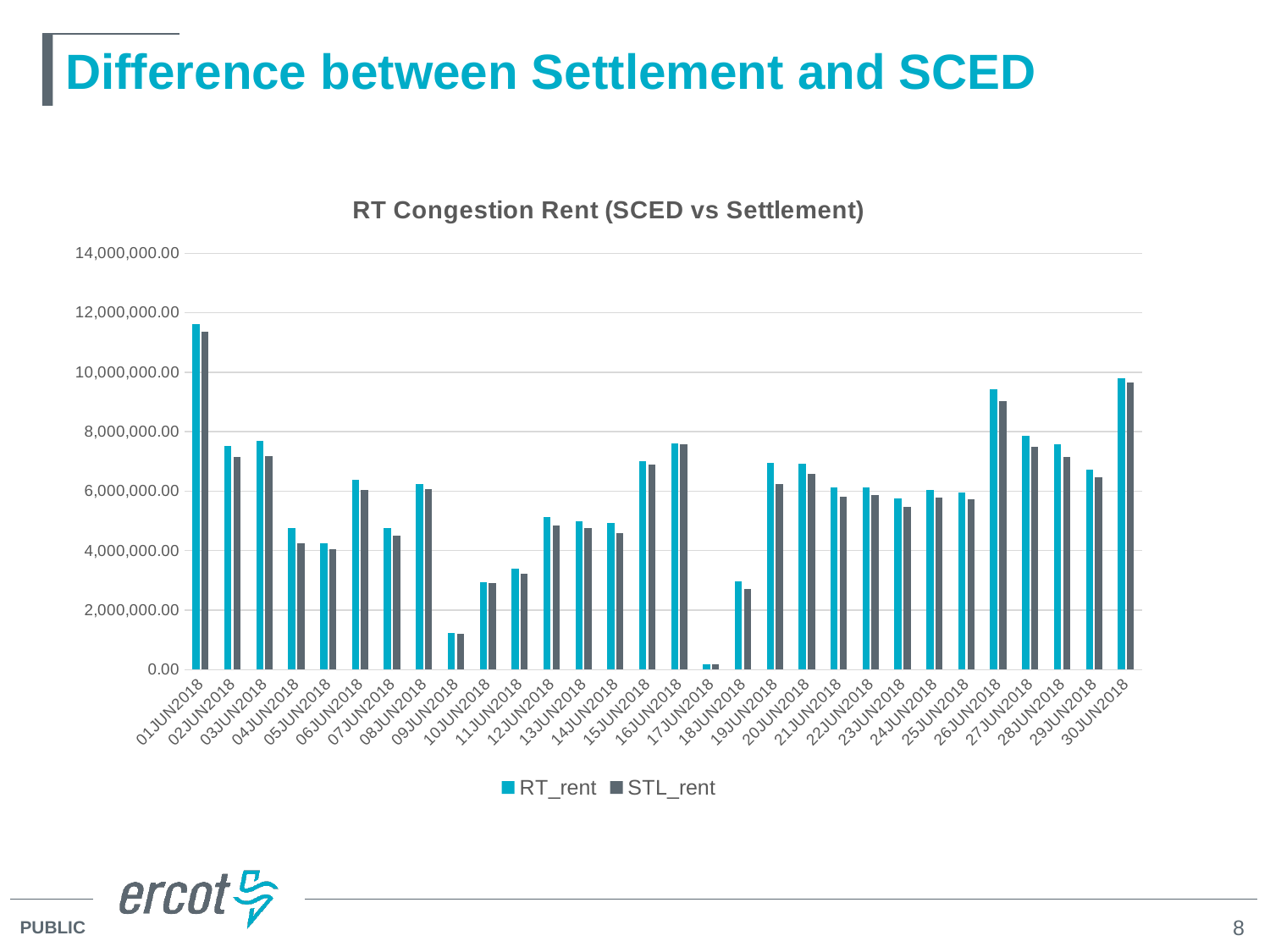
Which has the larger STL_rent value, 17JUN2018 or 18JUN2018? 18JUN2018 What kind of chart is shown on the slide? Bar chart Is the RT_rent value for 09JUN2018 greater or less than 2,000,000.00? less Which date has the highest RT_rent value? 01JUN2018 Is the RT_rent value for 01JUN2018 greater or less than 10,000,000.00? greater How many dates are shown along the x axis? 30 What is the title of the chart? RT Congestion Rent (SCED vs Settlement) How many series does the legend list? 2 Is the STL_rent value for 30JUN2018 greater or less than 8,000,000.00? greater Which date has the lowest RT_rent value? 17JUN2018 Which has the larger RT_rent value, 27JUN2018 or 28JUN2018? 27JUN2018